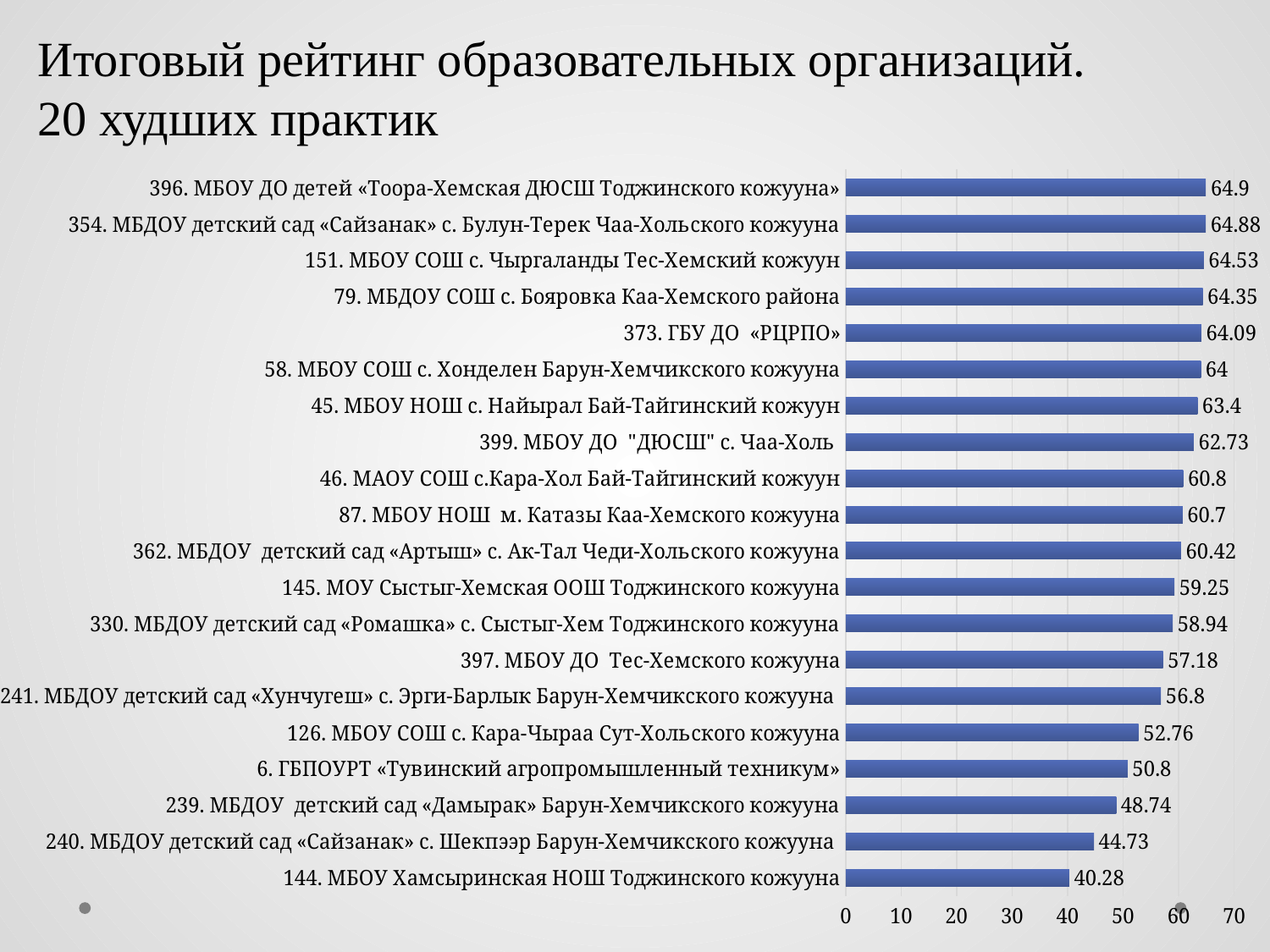
What is the difference between the values for 126. МБОУ СОШ с. Кара-Чыраа Сут-Хольского кожууна and 6. ГБПОУРТ «Тувинский агропромышленный техникум»? 1.96 Which organisation has the lowest value on the chart? 144. МБОУ Хамсыринская НОШ Тоджинского кожууна What is the difference between the values for 396. МБОУ ДО детей «Тоора-Хемская ДЮСШ Тоджинского кожууна» and 144. МБОУ Хамсыринская НОШ Тоджинского кожууна? 24.62 How many organisations are shown on the chart? 20 What is the value for 144. МБОУ Хамсыринская НОШ Тоджинского кожууна? 40.28 What kind of chart is shown on the slide? Bar chart What is the value for 373. ГБУ ДО «РЦРПО»? 64.09 Which organisation has the highest value on the chart? 396. МБОУ ДО детей «Тоора-Хемская ДЮСШ Тоджинского кожууна» What is the value for 6. ГБПОУРТ «Тувинский агропромышленный техникум»? 50.8 Which has a larger value: 240. МБДОУ детский сад «Сайзанак» с. Шекпээр Барун-Хемчикского кожууна or 239. МБДОУ детский сад «Дамырак» Барун-Хемчикского кожууна? 239. МБДОУ детский сад «Дамырак» Барун-Хемчикского кожууна Is the value for 241. МБДОУ детский сад «Хунчугеш» с. Эрги-Барлык Барун-Хемчикского кожууна greater or less than 50? greater What is the value for 397. МБОУ ДО Тес-Хемского кожууна? 57.18